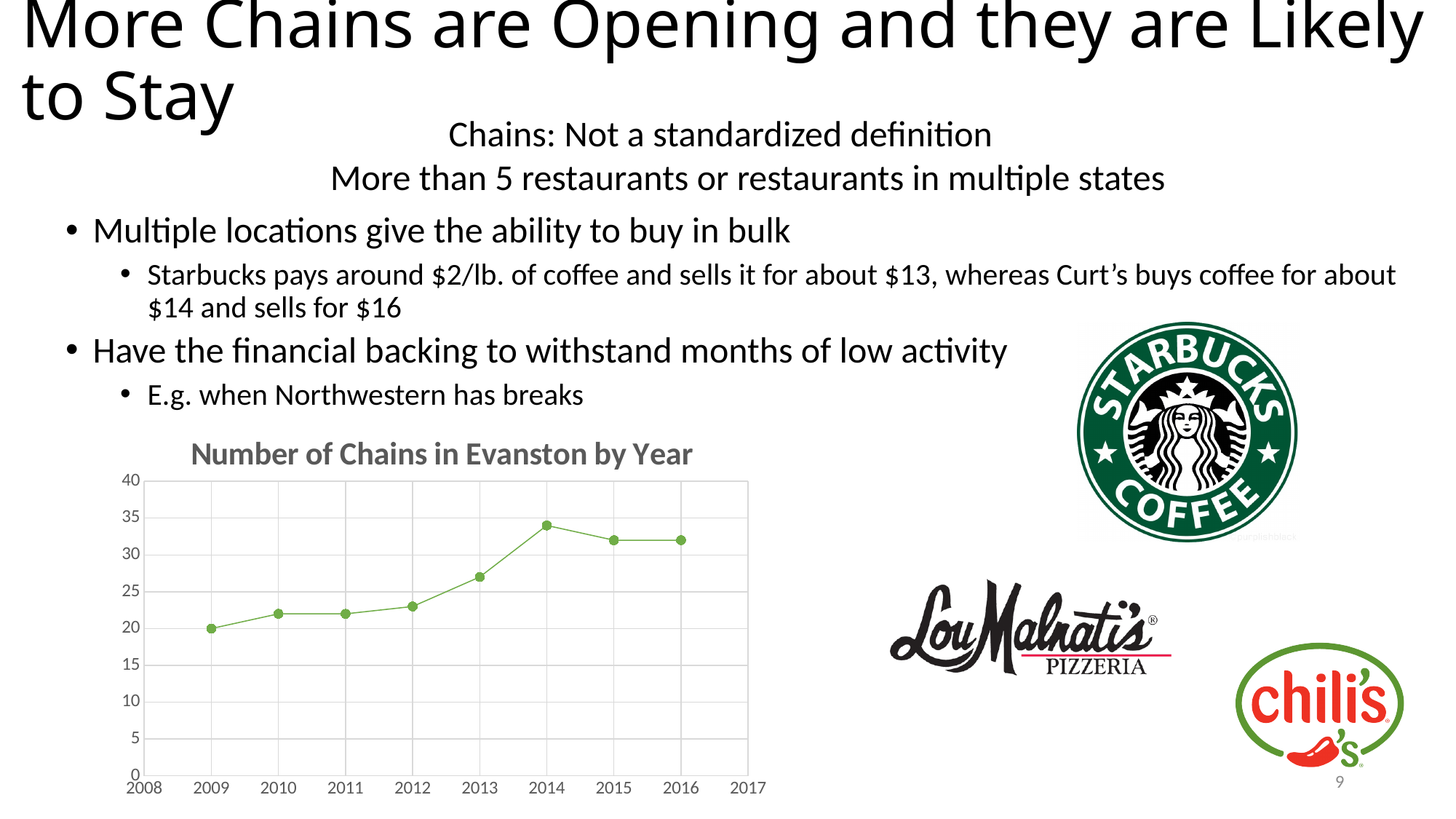
What is the number of chains in 2009? 20 Is the value for 2014 greater or less than 30? greater What is the title of the chart? Number of Chains in Evanston by Year How many data points are plotted on the chart? 8 Which year has the highest number of chains? 2014 Which year has more chains, 2013 or 2014? 2014 Do the values generally rise or fall from 2009 to 2014? rise Which year has the lowest number of chains? 2009 Is the value for 2012 greater or less than 25? less What kind of chart is shown on the slide? line chart Is the value for 2016 greater or less than 30? greater